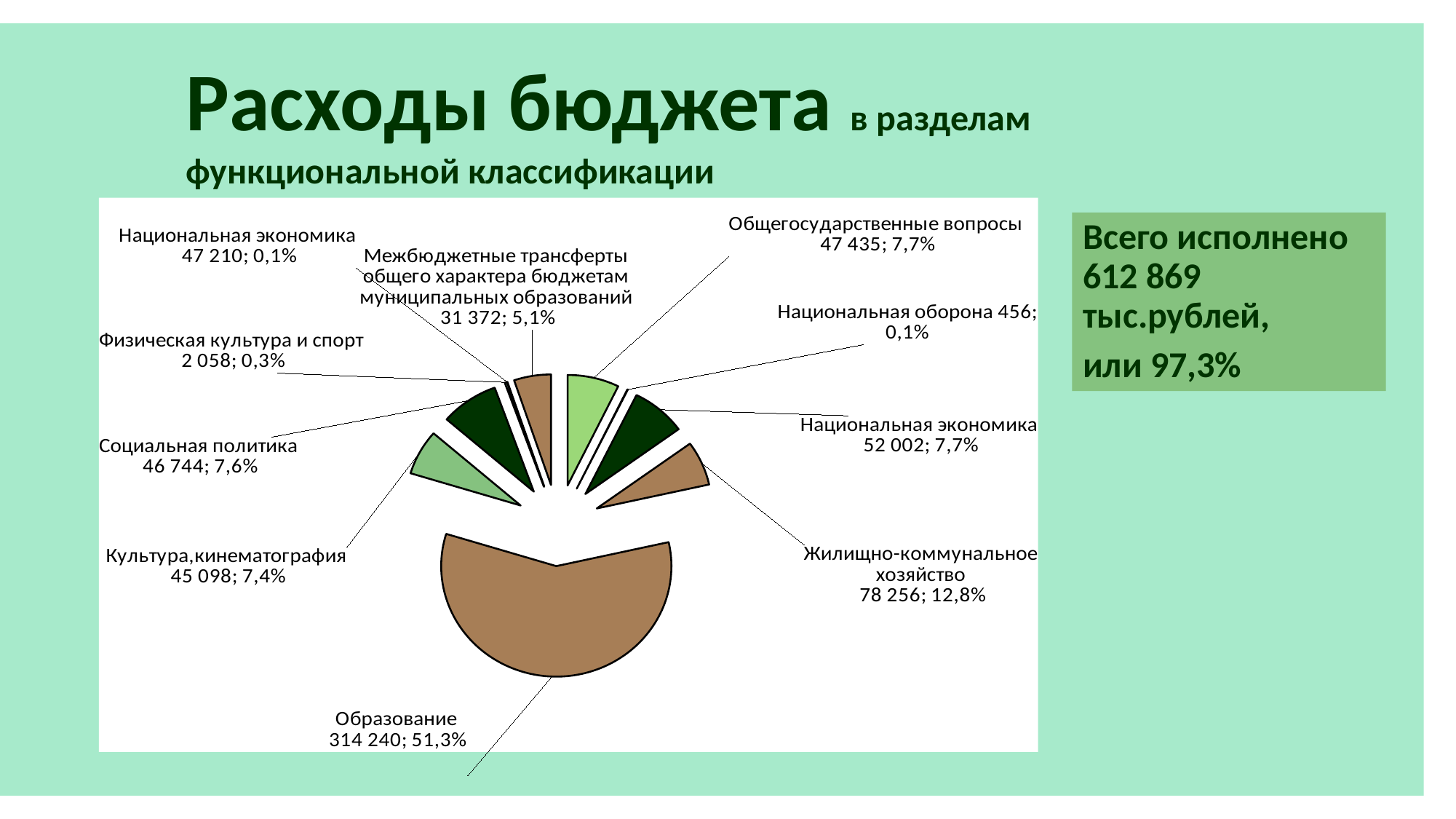
What kind of chart is shown on the slide? pie chart Which category has the largest slice of the pie? Образование What is the value shown for Жилищно-коммунальное хозяйство? 78 256 What is the value shown for Межбюджетные трансферты общего характера бюджетам муниципальных образований? 31 372 What share of the pie does Образование account for? 51,3% What is the value shown for Образование? 314 240 How many slices are labelled in the pie chart? 10 What is the difference between the values for Общегосударственные вопросы and Культура,кинематография? 2 337 Which is larger: Жилищно-коммунальное хозяйство or Социальная политика? Жилищно-коммунальное хозяйство What is the value shown for Физическая культура и спорт? 2 058 What share of the pie does Жилищно-коммунальное хозяйство account for? 12,8% Which category has the smallest value in the pie chart? Национальная оборона